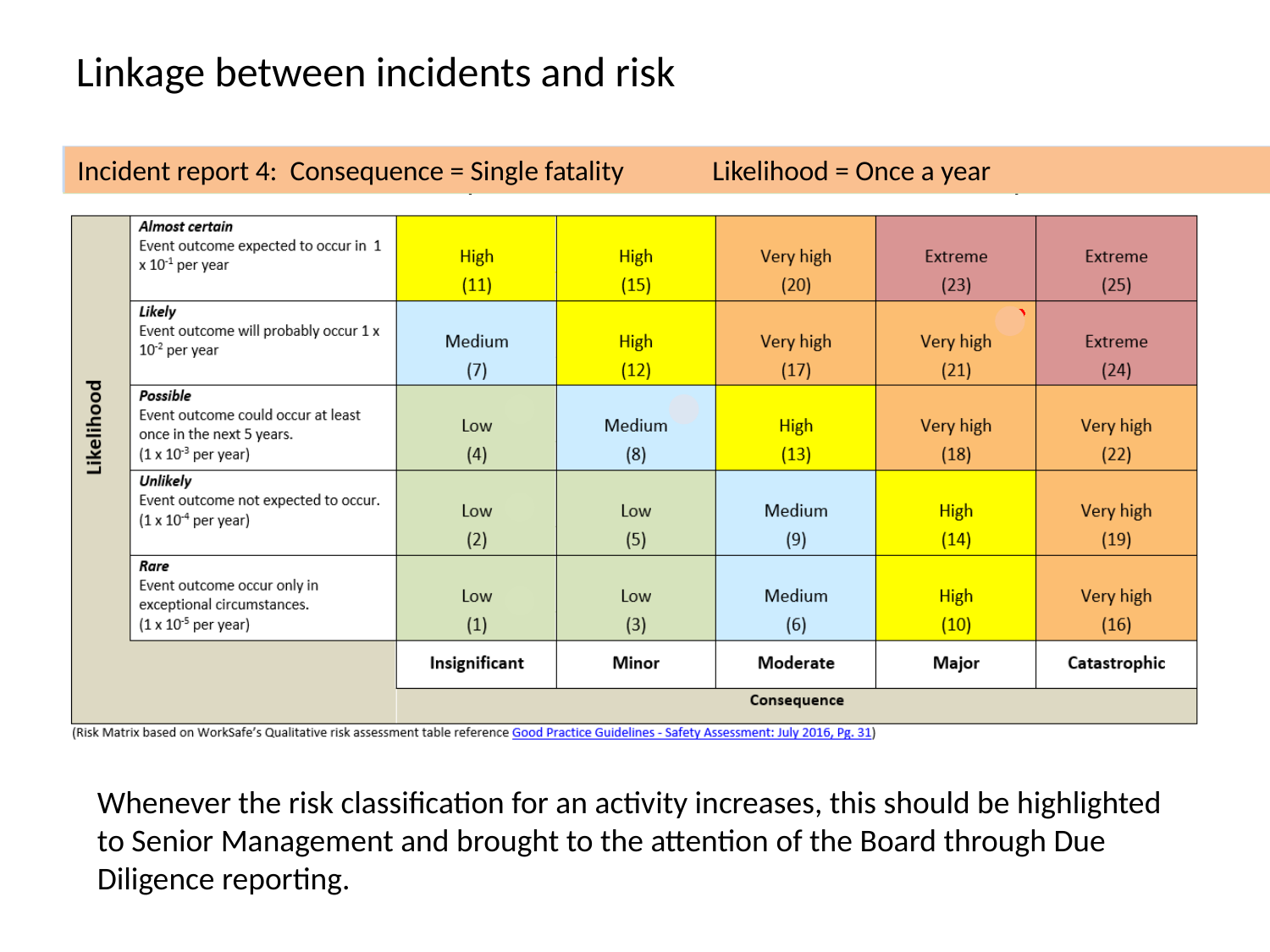
What is the risk rating and score for Rare likelihood and Catastrophic consequence? Very high (16) What is the risk rating and score for Likely likelihood and Major consequence? Very high (21) What kind of chart is shown on the slide? Risk matrix (heat map) What colour are the cells rated Extreme in the matrix? Red (dark pink) What is the difference between the scores for Almost certain/Major and Unlikely/Major? 9 Which has the higher score: Likely/Moderate or Possible/Major? Possible/Major What is the risk rating and score for Possible likelihood and Minor consequence? Medium (8) How many likelihood levels are listed on the vertical axis of the matrix? 5 How many consequence categories are listed along the bottom of the matrix? 5 Which cell of the matrix has the highest score? Almost certain / Catastrophic (25) Which cell of the matrix has the lowest score? Rare / Insignificant (1) What is the label of the horizontal axis of the matrix? Consequence